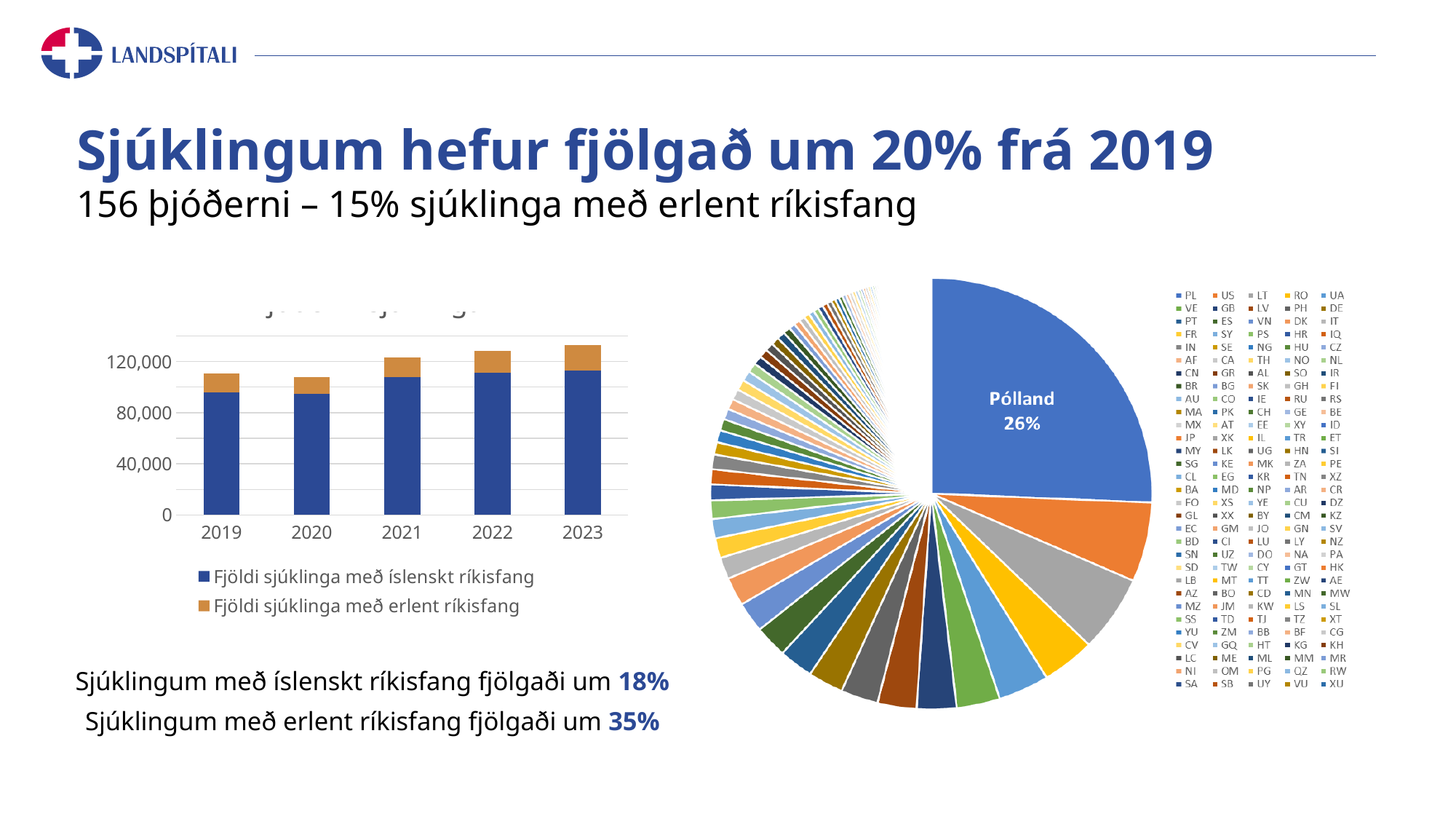
In the bar chart on the left, is the total height of the 2020 bar greater or less than 120,000? less In the bar chart on the left, is the total height of the 2023 bar greater or less than 120,000? greater In the bar chart on the left, how many series does the legend list? 2 In the bar chart on the left, is the value for Fjöldi sjúklinga með íslenskt ríkisfang in 2019 greater or less than 80,000? greater In the bar chart on the left, which series is shown in dark blue? Fjöldi sjúklinga með íslenskt ríkisfang In the bar chart on the left, which year has the tallest stacked bar? 2023 In the bar chart on the left, do the total bar heights rise or fall from 2020 to 2023? rise What kind of chart is the chart on the left of the slide? Bar chart (stacked) In the bar chart on the left, is the Fjöldi sjúklinga með íslenskt ríkisfang value larger in 2019 or in 2023? 2023 What kind of chart is the chart on the right of the slide? Pie chart In the pie chart on the right, what share of the pie does Pólland have? 26% In the bar chart on the left, how many years are shown on the x axis? 5